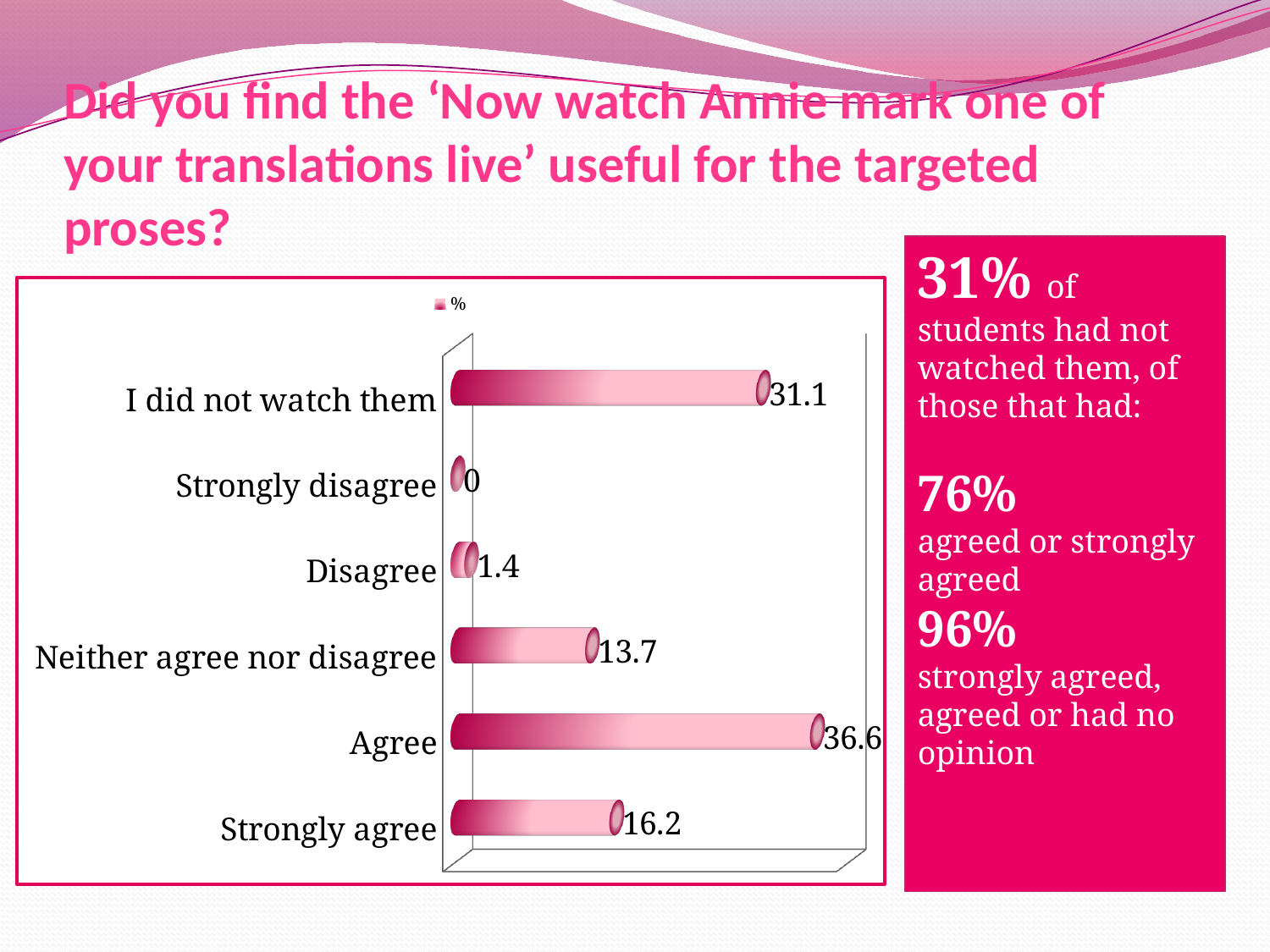
What kind of chart is shown? Bar chart How many categories are shown in the chart? 6 What is the value for 'I did not watch them'? 31.1 What is the legend entry for the series? % What is the value for 'Agree'? 36.6 Which category has the lowest value? Strongly disagree How many series does the legend list? 1 Which category has the highest value? Agree What is the value for 'Neither agree nor disagree'? 13.7 Which is larger, the value for 'Disagree' or the value for 'Neither agree nor disagree'? Neither agree nor disagree What is the difference between the values for 'Agree' and 'Strongly agree'? 20.4 What is the value for 'Strongly disagree'? 0